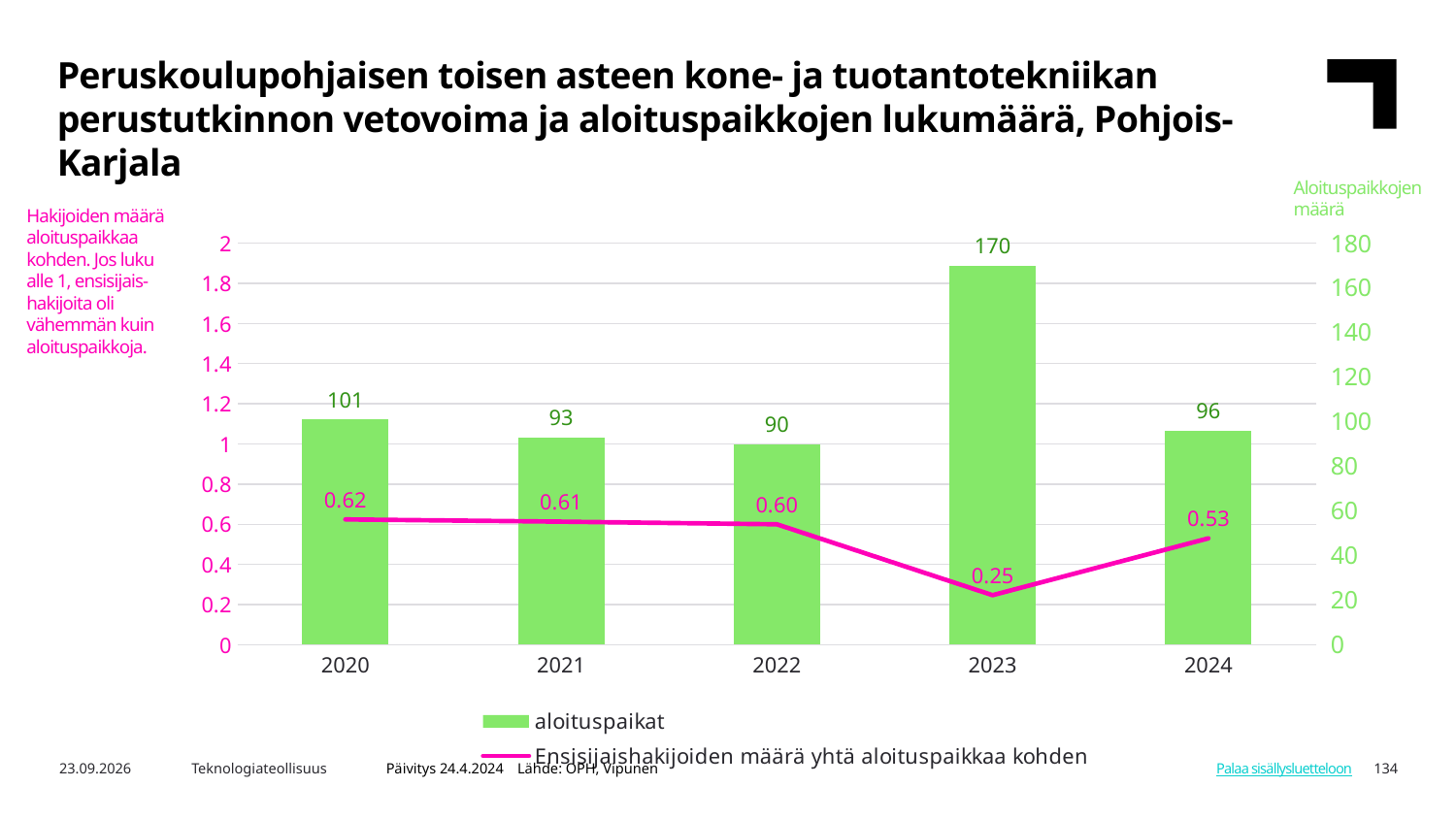
How many years are shown on the x axis? 5 What colour are the aloituspaikat bars? green Which year has more aloituspaikat, 2020 or 2021? 2020 How many series does the legend list? 2 Which year has the lowest value of Ensisijaishakijoiden määrä yhtä aloituspaikkaa kohden? 2023 What kind of chart is used for the aloituspaikat series? bar chart What is the value of Ensisijaishakijoiden määrä yhtä aloituspaikkaa kohden for 2020? 0.62 What is the value of aloituspaikat for 2023? 170 What is the value of aloituspaikat for 2024? 96 Does the Ensisijaishakijoiden määrä yhtä aloituspaikkaa kohden line rise or fall from 2020 to 2023? fall What is the difference in aloituspaikat between 2023 and 2022? 80 Which year has the highest number of aloituspaikat? 2023